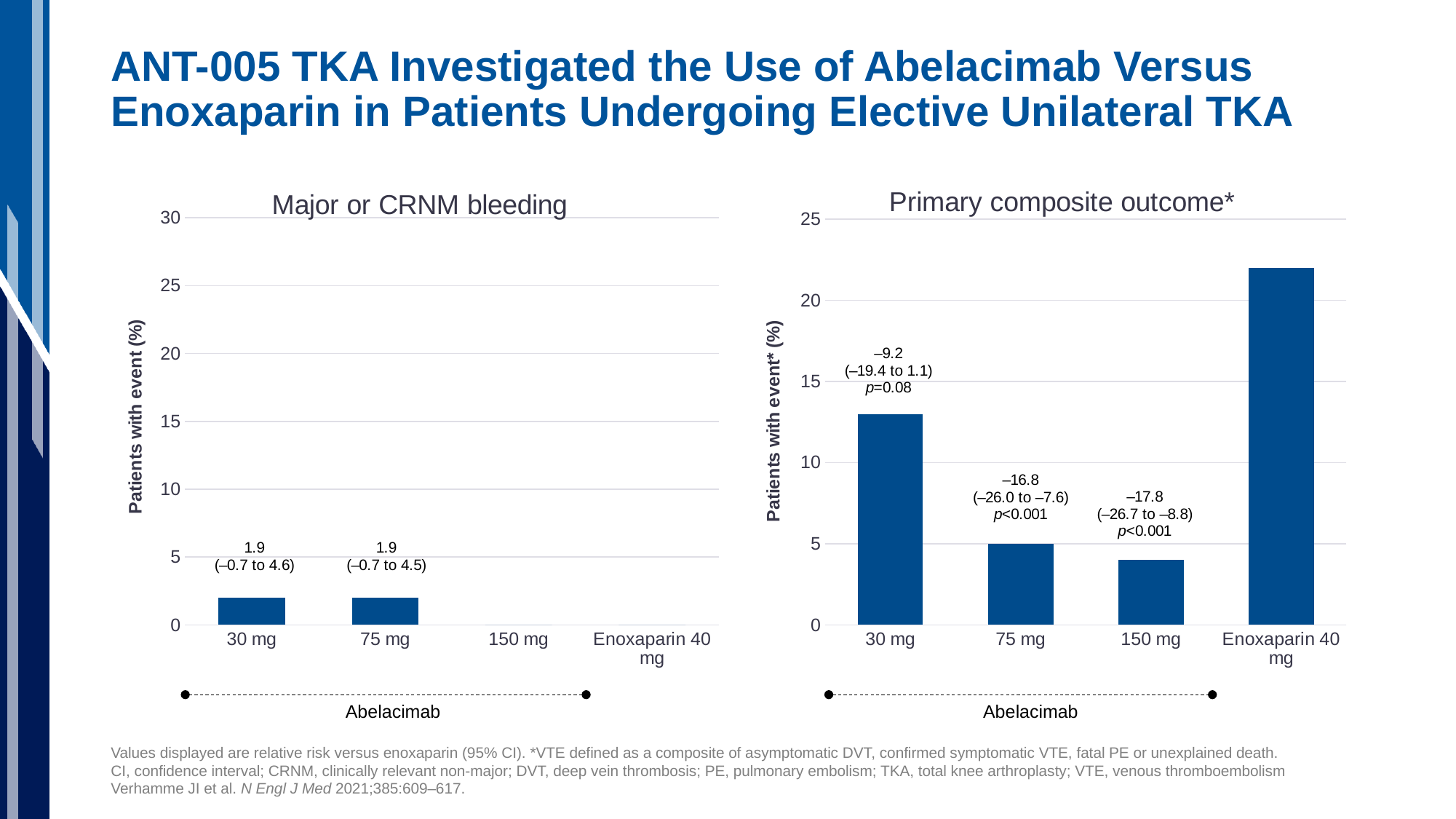
How many categories are shown on the x axis of the "Primary composite outcome*" chart? 4 In the "Primary composite outcome*" chart, is the value for 30 mg greater or less than 10? greater In the "Primary composite outcome*" chart, which category has the highest value? Enoxaparin 40 mg In the "Primary composite outcome*" chart, what relative risk value is printed above the 30 mg bar? –9.2 In the "Major or CRNM bleeding" chart, is the value for 30 mg greater or less than 5? less What kind of chart is the "Major or CRNM bleeding" chart? Bar chart In the "Primary composite outcome*" chart, is the value for Enoxaparin 40 mg greater or less than 20? greater In the "Major or CRNM bleeding" chart, what confidence interval is printed above the 75 mg bar? (–0.7 to 4.5) What is the title of the chart on the right side of the slide? Primary composite outcome* In the "Primary composite outcome*" chart, which is larger, the value for 30 mg or the value for 75 mg? 30 mg What is the y-axis label of the "Major or CRNM bleeding" chart? Patients with event (%) In the "Primary composite outcome*" chart, which category has the lowest value? 150 mg